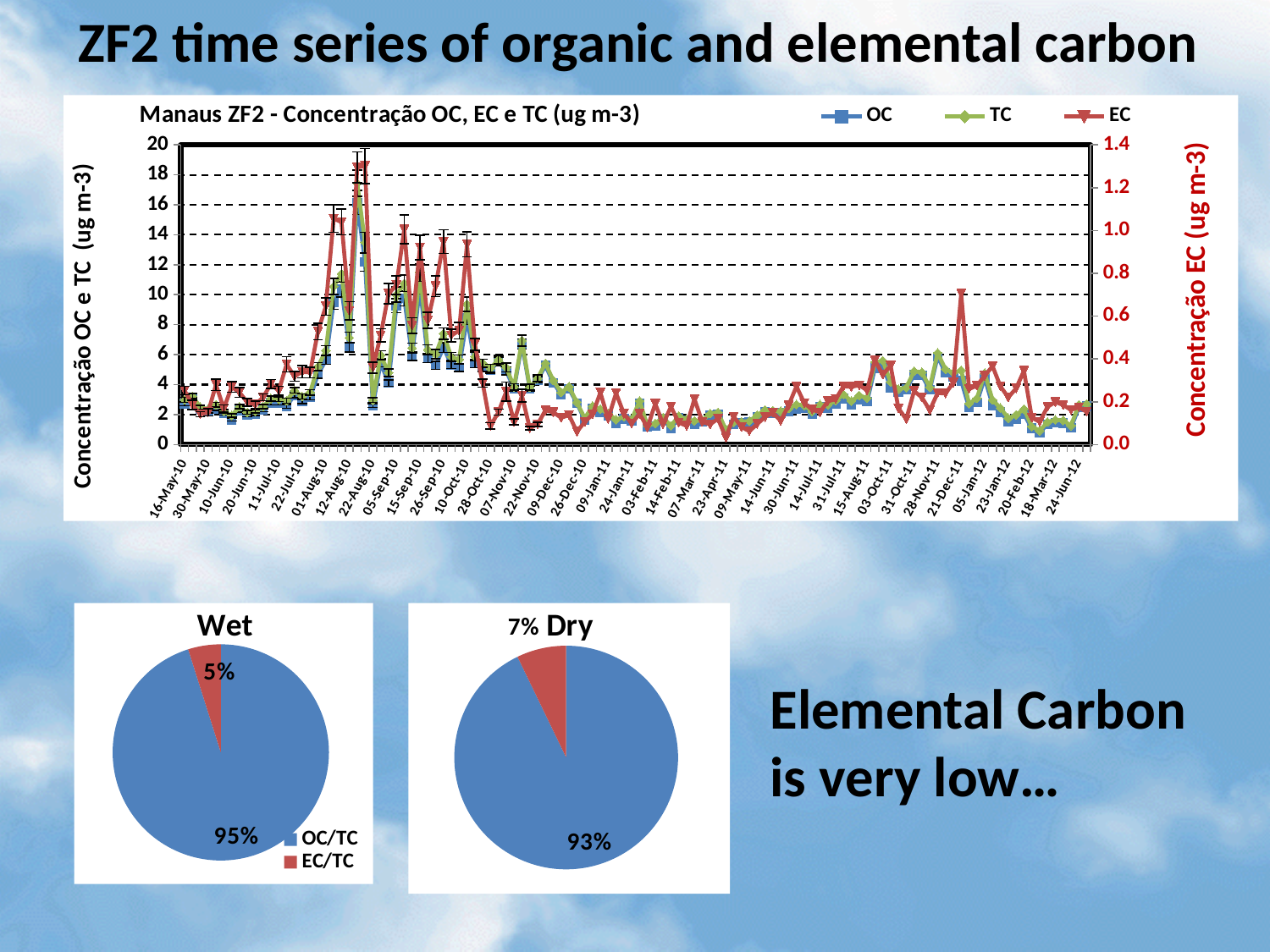
In the "Wet" pie chart, what share does OC/TC have? 95% In the "Wet" pie chart, what is the difference between the OC/TC share and the EC/TC share? 90% In the "Dry" pie chart, what share does OC/TC have? 93% What kind of chart is the top chart titled "Manaus ZF2 - Concentração OC, EC e TC (ug m-3)"? line chart In the top line chart, do the TC values rise or fall between 22-Aug-10 and 26-Dec-10? fall In the "Dry" pie chart, what share does EC/TC have? 7% In the top line chart, is the OC value at 16-May-10 greater or less than 4 on the left axis? less In the top line chart, is the peak value of the TC series around 22-Aug-10 greater or less than 14 on the left axis? greater How many series does the legend of the top line chart list? 3 Which pie chart shows the larger EC/TC share, "Wet" or "Dry"? Dry In the top line chart, which series is plotted against the right-hand axis labelled "Concentração EC (ug m-3)"? EC